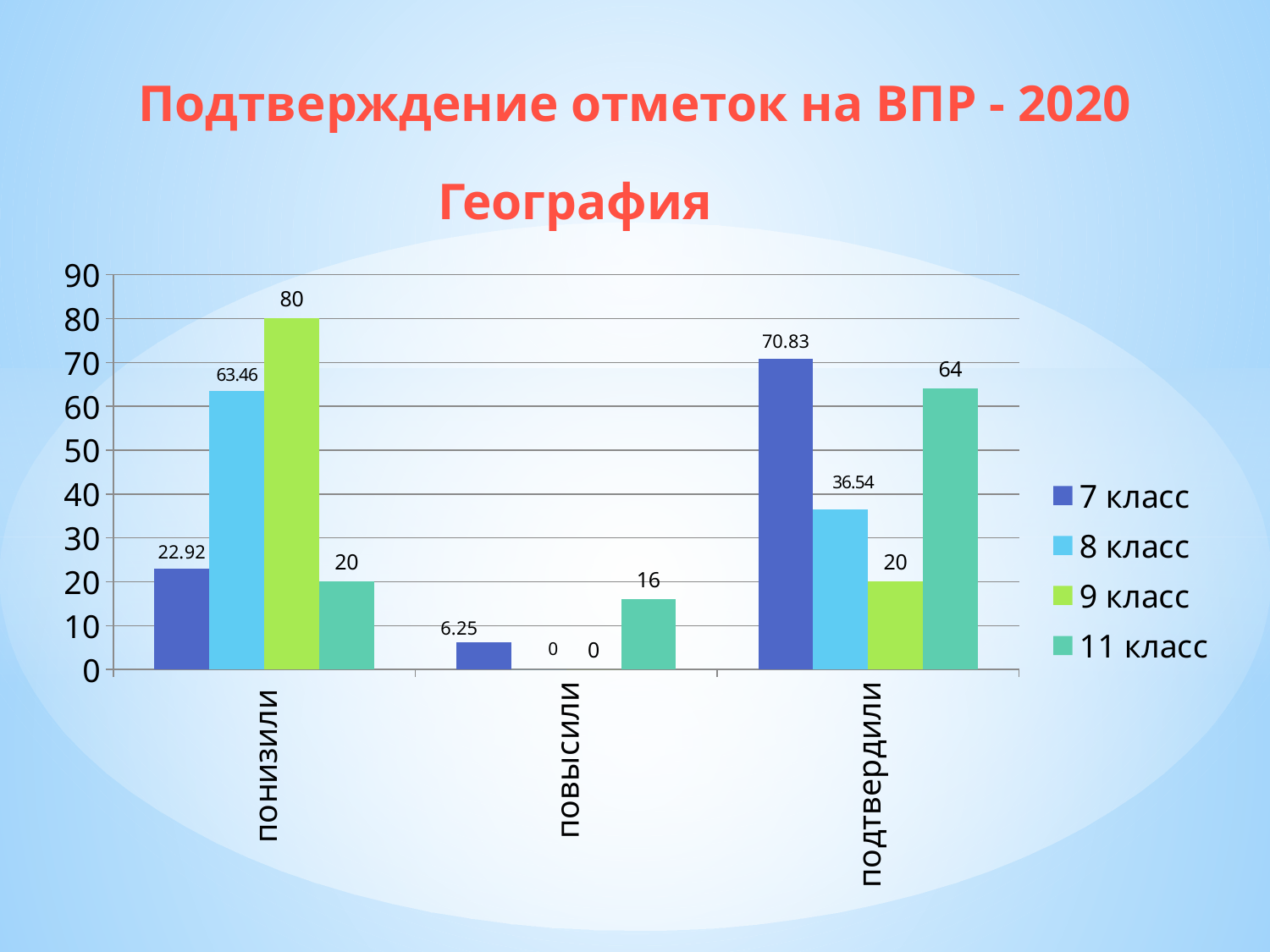
What is the value for 7 класс in the подтвердили category? 70.83 What kind of chart is shown on the slide? Bar chart What is the difference between the 7 класс and 8 класс values in the подтвердили category? 34.29 What is the value for 8 класс in the понизили category? 63.46 What is the subject named in the chart title? География Which is larger: the 11 класс value for подтвердили or the 8 класс value for понизили? 11 класс value for подтвердили Which series has the lowest value in the понизили category? 11 класс What is the value for 11 класс in the повысили category? 16 Which series has the highest value in the подтвердили category? 7 класс What is the value for 9 класс in the понизили category? 80 How many series does the legend list? 4 How many categories are shown on the x axis? 3